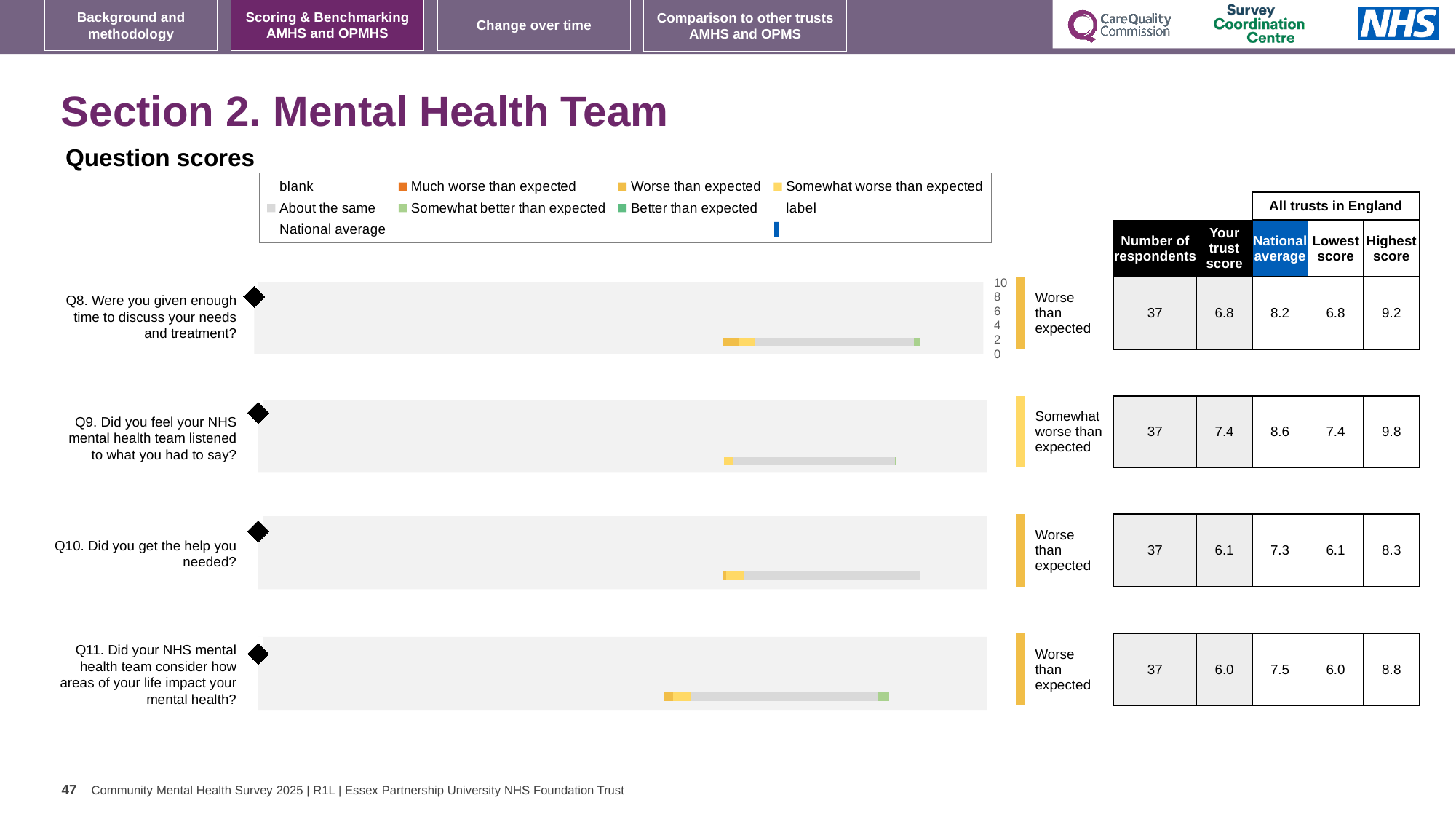
Which question has the highest trust score? Q9 What is the lowest score among all trusts in England for Q10? 6.1 What is the trust score for Q9 (Did you feel your NHS mental health team listened to what you had to say)? 7.4 What is the national average score for Q10 (Did you get the help you needed)? 7.3 How many questions are plotted on the slide? 4 What benchmark category is shown next to the Q9 chart? Somewhat worse than expected Which has the larger trust score, Q9 or Q10? Q9 What is the difference between the national average and the trust score for Q8? 1.4 What kind of chart is used to show the question scores? Bar chart How many respondents answered Q8? 37 What is the highest score among all trusts in England for Q11? 8.8 Which question has the lowest trust score? Q11